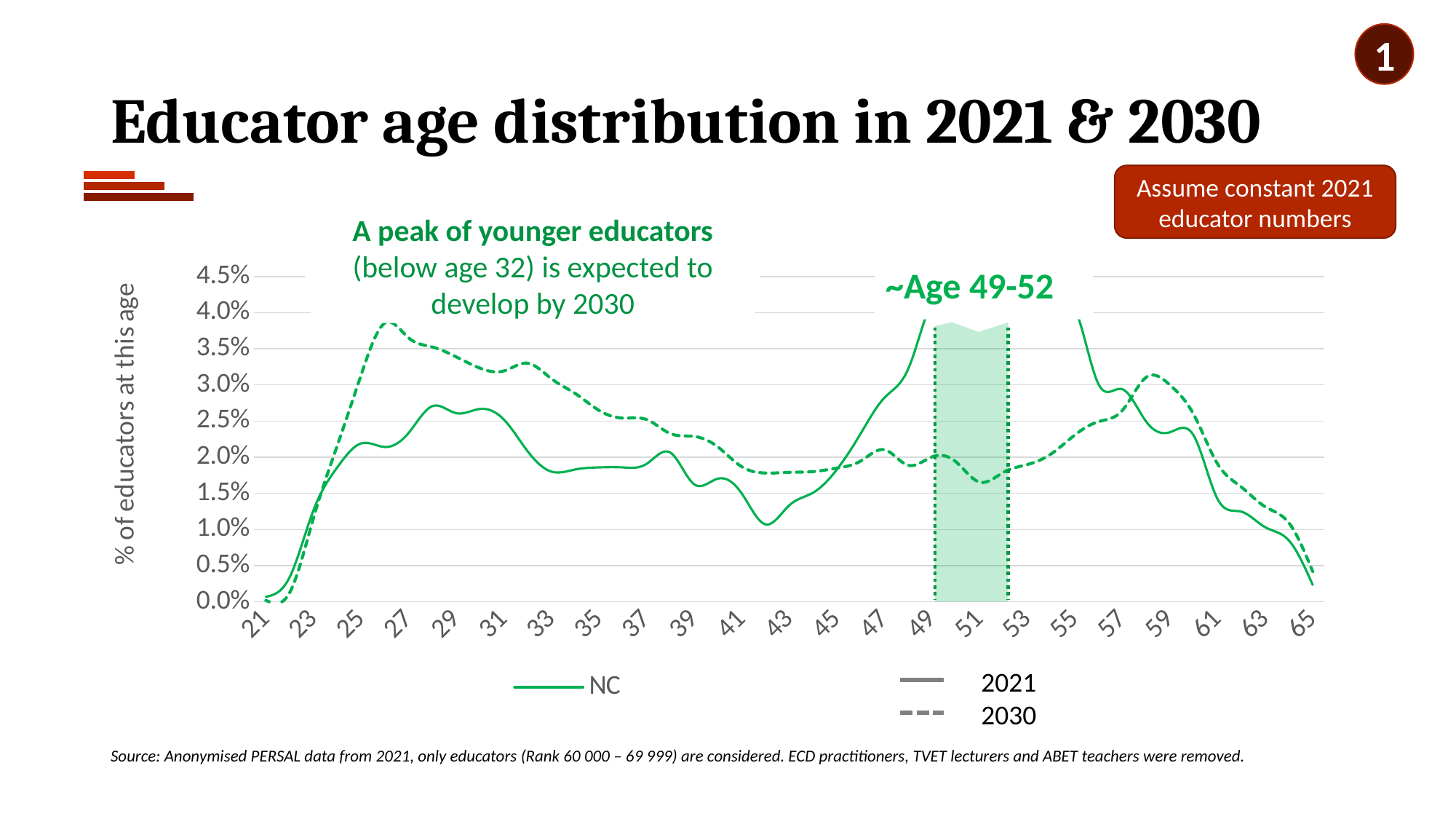
What kind of chart is shown on the slide? Line chart Is the 2030 value at age 51 greater or less than 2.0%? less At age 27, which series has the higher value, 2021 or 2030? 2030 Is the 2030 value at age 27 greater or less than 3.5%? greater Is the 2021 value at age 65 greater or less than 0.5%? less Does the 2030 line rise or fall between age 21 and age 27? Rise What is the label on the vertical axis of the chart? % of educators at this age What is the title of the slide's chart? Educator age distribution in 2021 & 2030 Does the 2021 line rise or fall between age 59 and age 65? Fall At age 49, which series has the higher value, 2021 or 2030? 2021